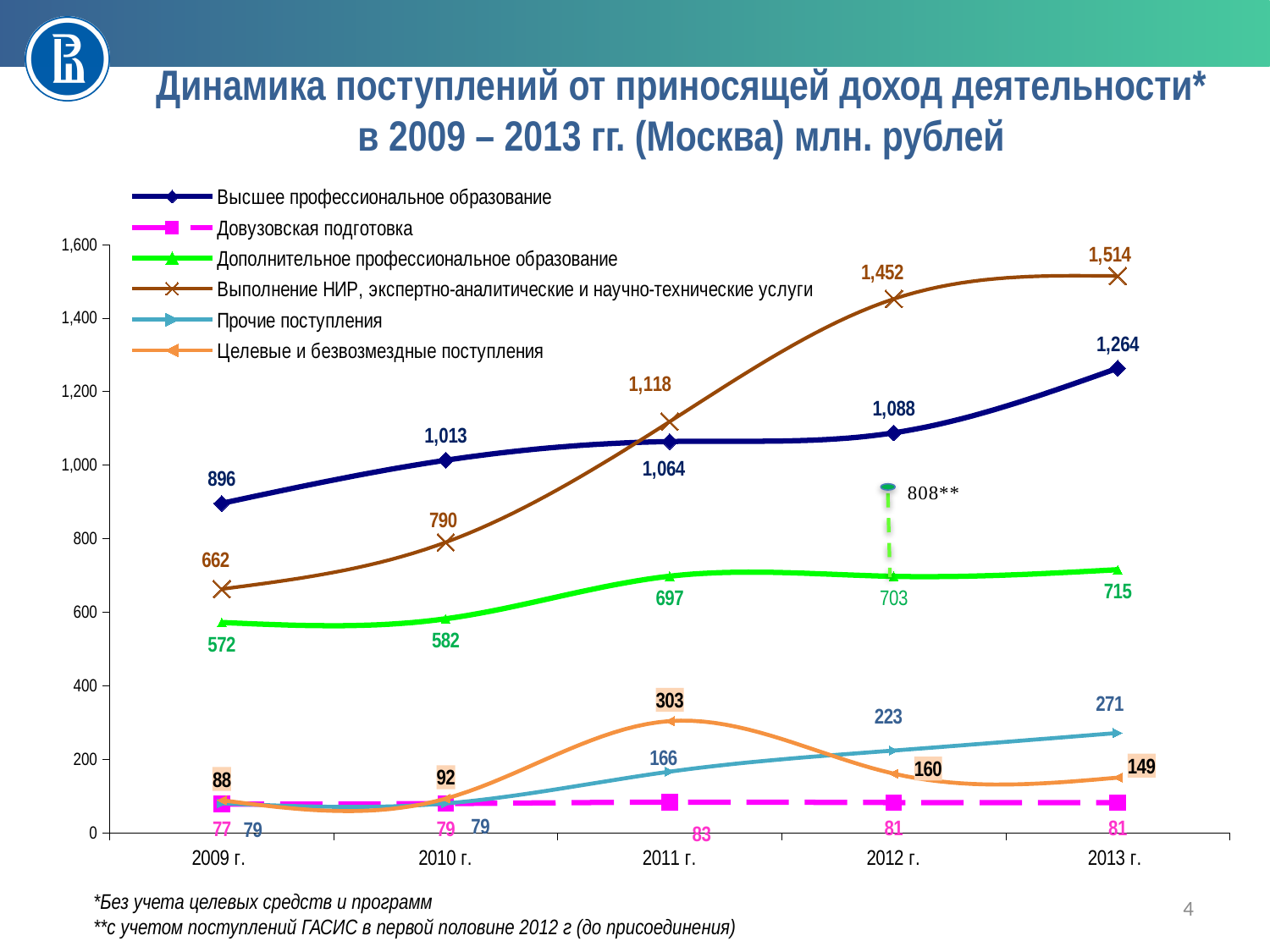
In which year is the value for Высшее профессиональное образование the highest? 2013 г. What kind of chart is shown on the slide? Line chart What is the value for Целевые и безвозмездные поступления in 2011 г.? 303 In which year is the value for Довузовская подготовка the lowest? 2009 г. How many years are shown on the x axis? 5 In 2011 г., which is larger: Высшее профессиональное образование or Выполнение НИР, экспертно-аналитические и научно-технические услуги? Выполнение НИР, экспертно-аналитические и научно-технические услуги What is the difference between the 2012 г. and 2011 г. values for Выполнение НИР, экспертно-аналитические и научно-технические услуги? 334 What is the value for Выполнение НИР, экспертно-аналитические и научно-технические услуги in 2013 г.? 1,514 How many series does the legend list? 6 What is the value for Высшее профессиональное образование in 2009 г.? 896 Do the values for Прочие поступления rise or fall from 2009 г. to 2013 г.? Rise What is the difference between the 2013 г. and 2009 г. values for Высшее профессиональное образование? 368